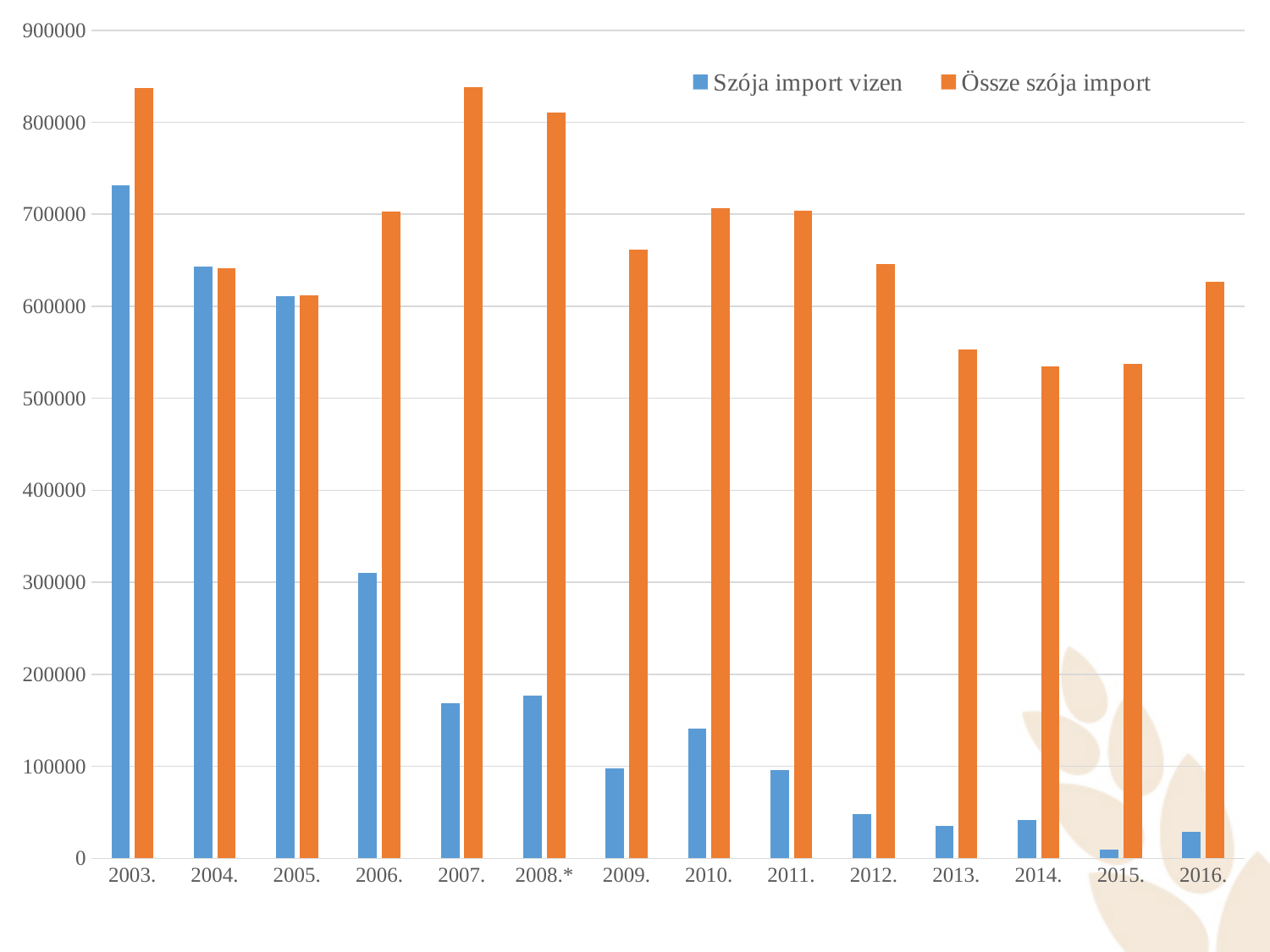
How many years are shown on the x axis? 14 Does the Szója import vizen series generally rise or fall from 2003. to 2016.? fall Which is larger, Össze szója import in 2009. or in 2013.? 2009. Which year has the lowest value for Szója import vizen? 2015. Which is larger, Szója import vizen in 2010. or in 2011.? 2010. Which year has the highest value for Szója import vizen? 2003. How many series does the legend list? 2 Is the value for Szója import vizen in 2012. greater or less than 100000? less Is the value for Össze szója import in 2016. greater or less than 600000? greater What kind of chart is shown on the slide? bar chart Is the value for Szója import vizen in 2006. greater or less than 200000? greater